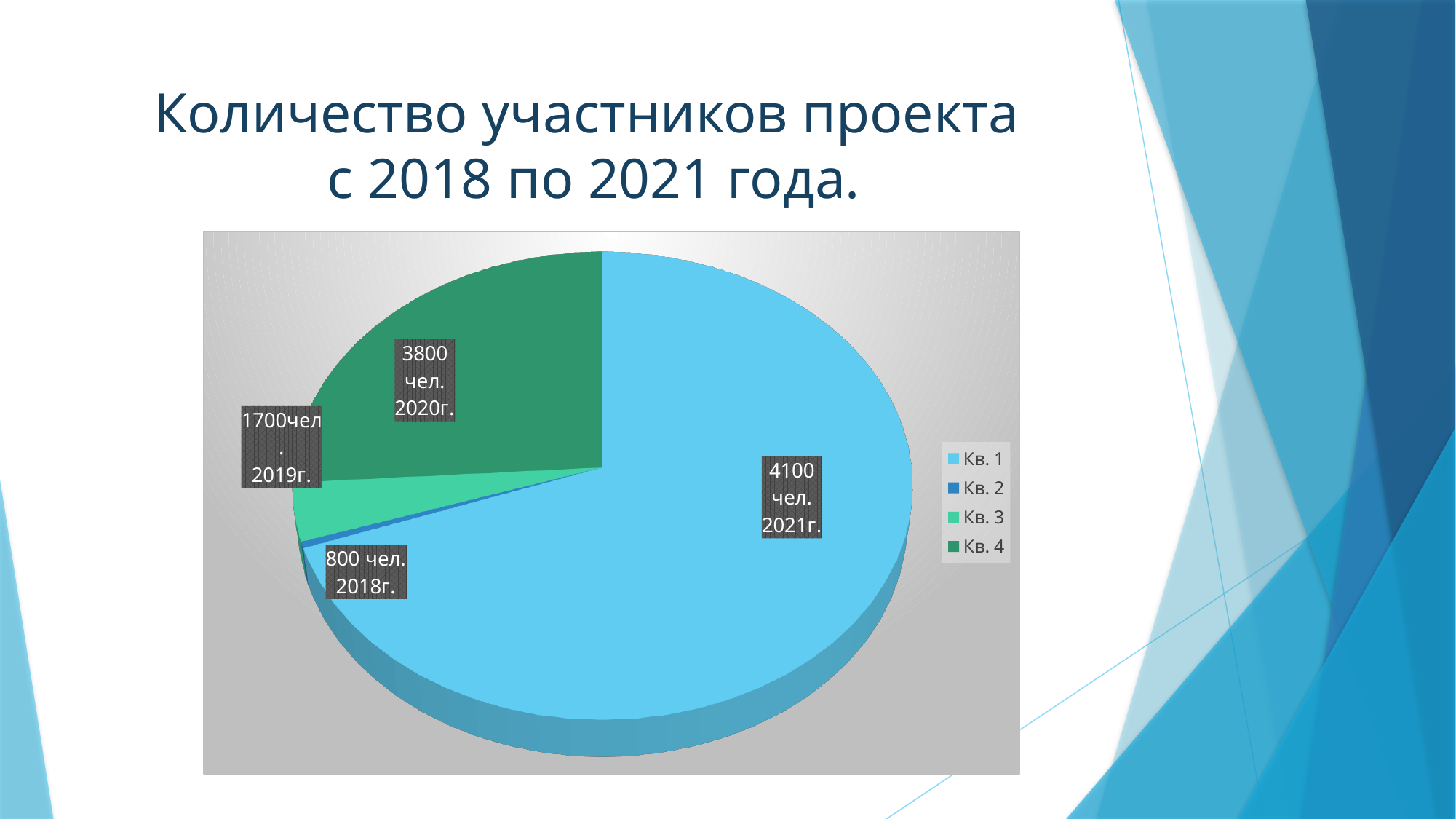
How many participants does the chart show for 2020? 3800 чел. Which year had more participants, 2019 or 2018? 2019 How many participants does the chart show for 2019? 1700чел. How many participants does the chart show for 2018? 800 чел. What kind of chart is shown on the slide? Pie chart Which year has the largest number of participants? 2021 How many slices does the pie chart have? 4 What is the difference in participants between 2019 and 2018? 900 How many entries does the chart legend list? 4 Which year has the smallest number of participants? 2018 What is the difference in participants between 2021 and 2020? 300 How many participants does the chart show for 2021? 4100 чел.